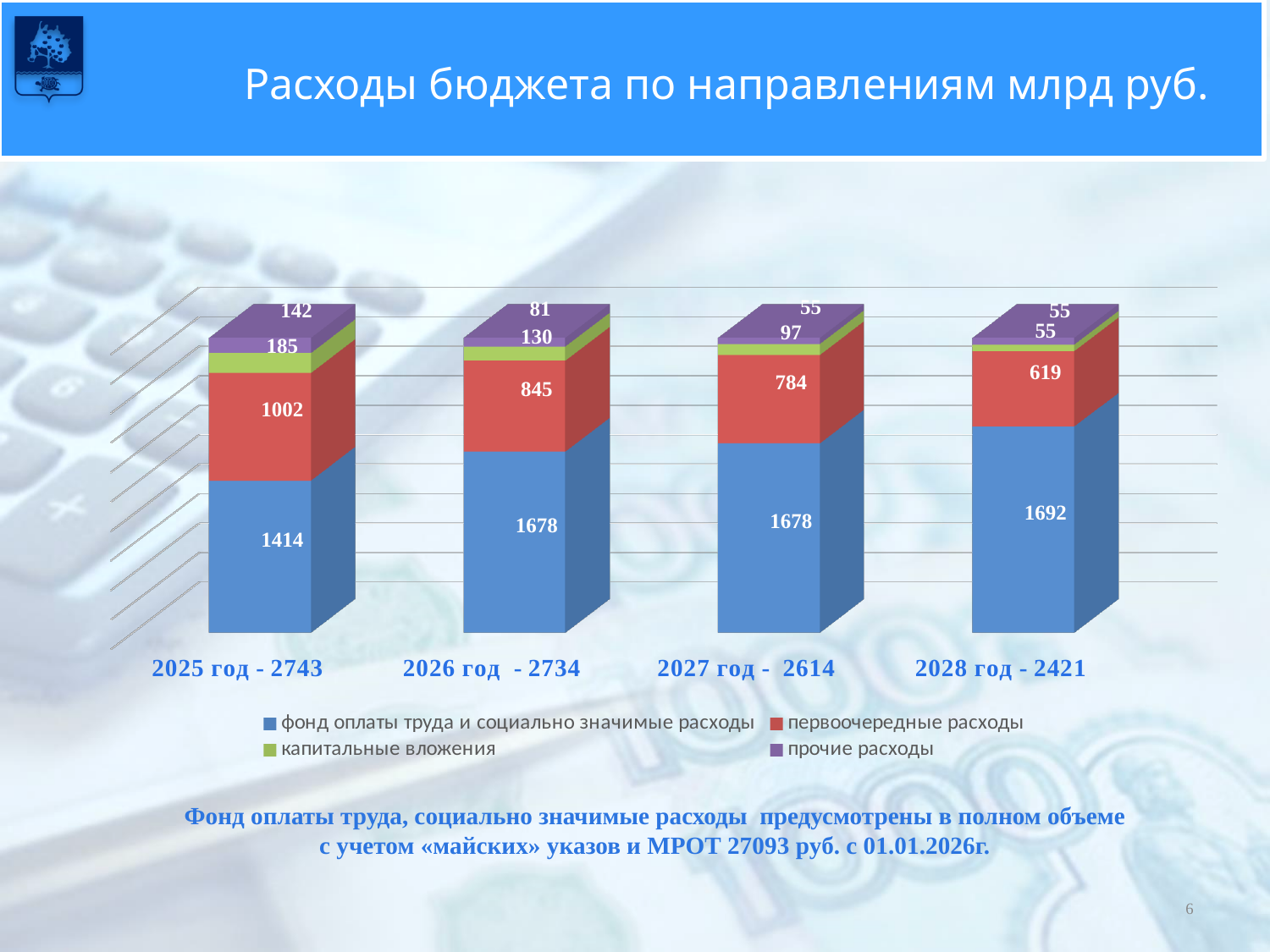
What kind of chart is shown on the slide? Stacked bar chart What is the difference between первоочередные расходы in 2025 год and 2028 год? 383 How many series does the legend list? 4 Which is larger: фонд оплаты труда и социально значимые расходы in 2025 год or in 2026 год? 2026 год What is the value of капитальные вложения for 2026 год? 130 What is the total of the stacked bar for 2027 год? 2614 What is the value of фонд оплаты труда и социально значимые расходы for 2028 год? 1692 What is the value of прочие расходы for 2027 год? 55 How many years (categories) are shown on the x axis? 4 What is the value of первоочередные расходы for 2025 год? 1002 Which year has the highest value for первоочередные расходы? 2025 год Which year has the lowest value for капитальные вложения? 2028 год